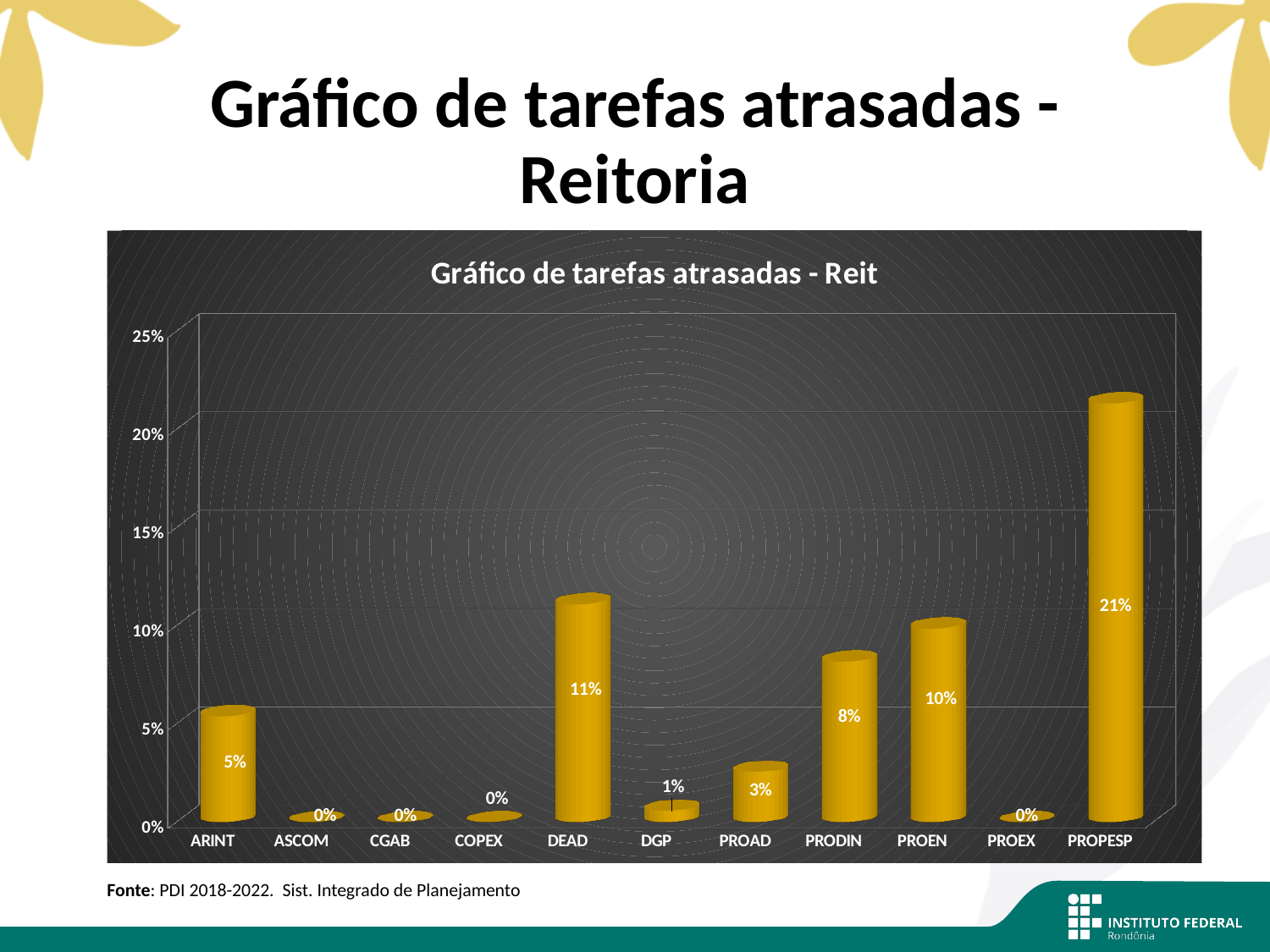
What is the value for DEAD? 11% What is the value for ARINT? 5% What is the difference between the values for PROPESP and DEAD? 10% Which category has the highest value? PROPESP What is the value for PROEN? 10% Is the value for PROPESP greater or less than 20%? greater Which is larger, the value for PROEN or the value for PRODIN? PROEN What is the title of the chart? Gráfico de tarefas atrasadas - Reit What is the difference between the values for PRODIN and PROAD? 5% How many categories are shown on the x axis? 11 What kind of chart is shown on the slide? Bar chart What is the value for PROPESP? 21%